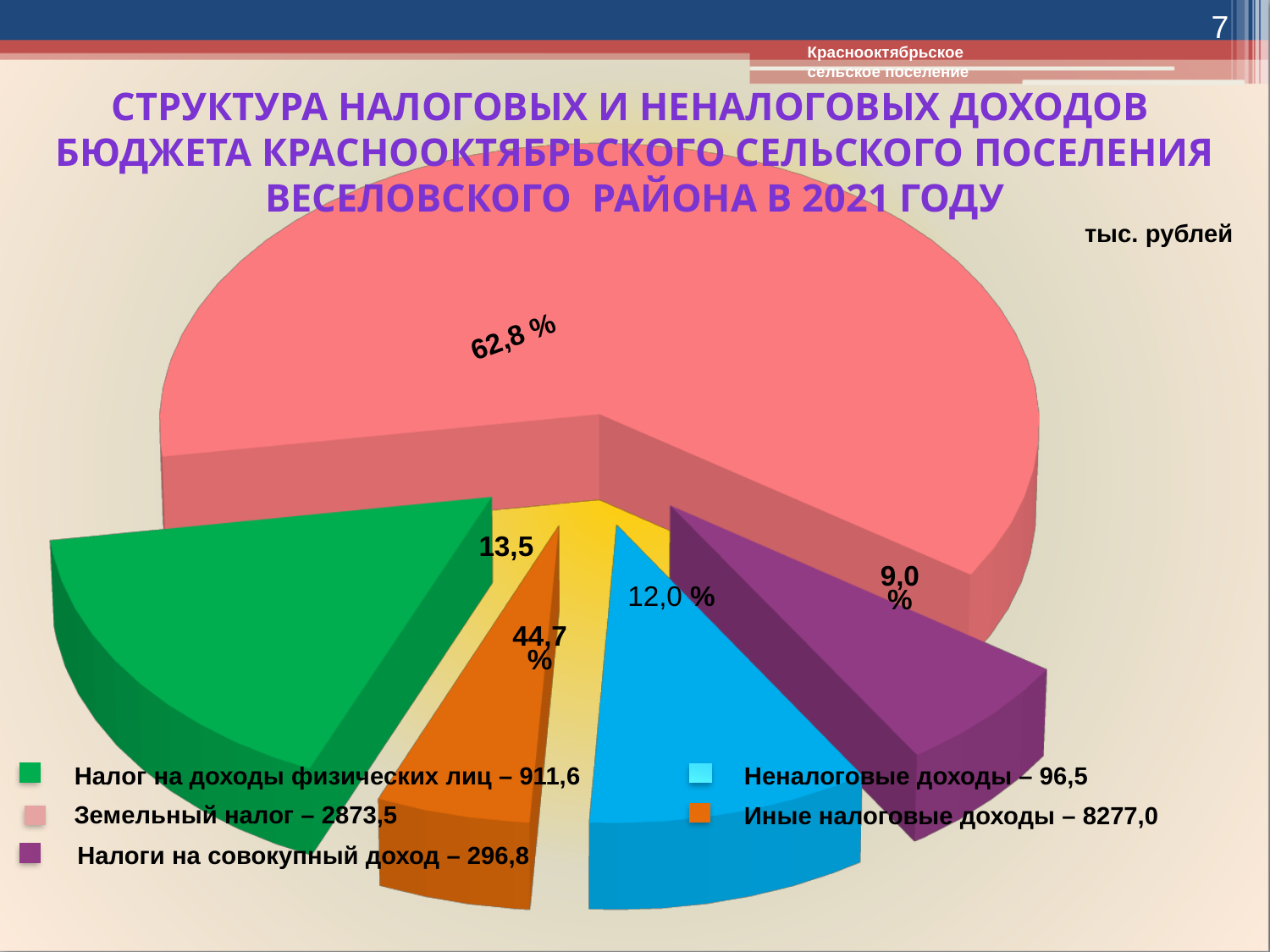
What kind of chart is shown on the slide? pie chart In what units are the values on the slide given? тыс. рублей What value is given in the legend for Неналоговые доходы? 96,5 What percentage label is shown on the pink slice (Земельный налог)? 62,8 % What value is given in the legend for Налоги на совокупный доход? 296,8 What value is given in the legend for Земельный налог? 2873,5 What is the difference between the legend values for Земельный налог and Налог на доходы физических лиц? 1961,9 How many categories does the legend of the pie chart list? 5 What percentage label is shown next to the blue slice (Неналоговые доходы)? 12,0 % Which category has the smallest value in the legend? Неналоговые доходы Which category has the largest value in the legend? Иные налоговые доходы What value is given in the legend for Налог на доходы физических лиц? 911,6